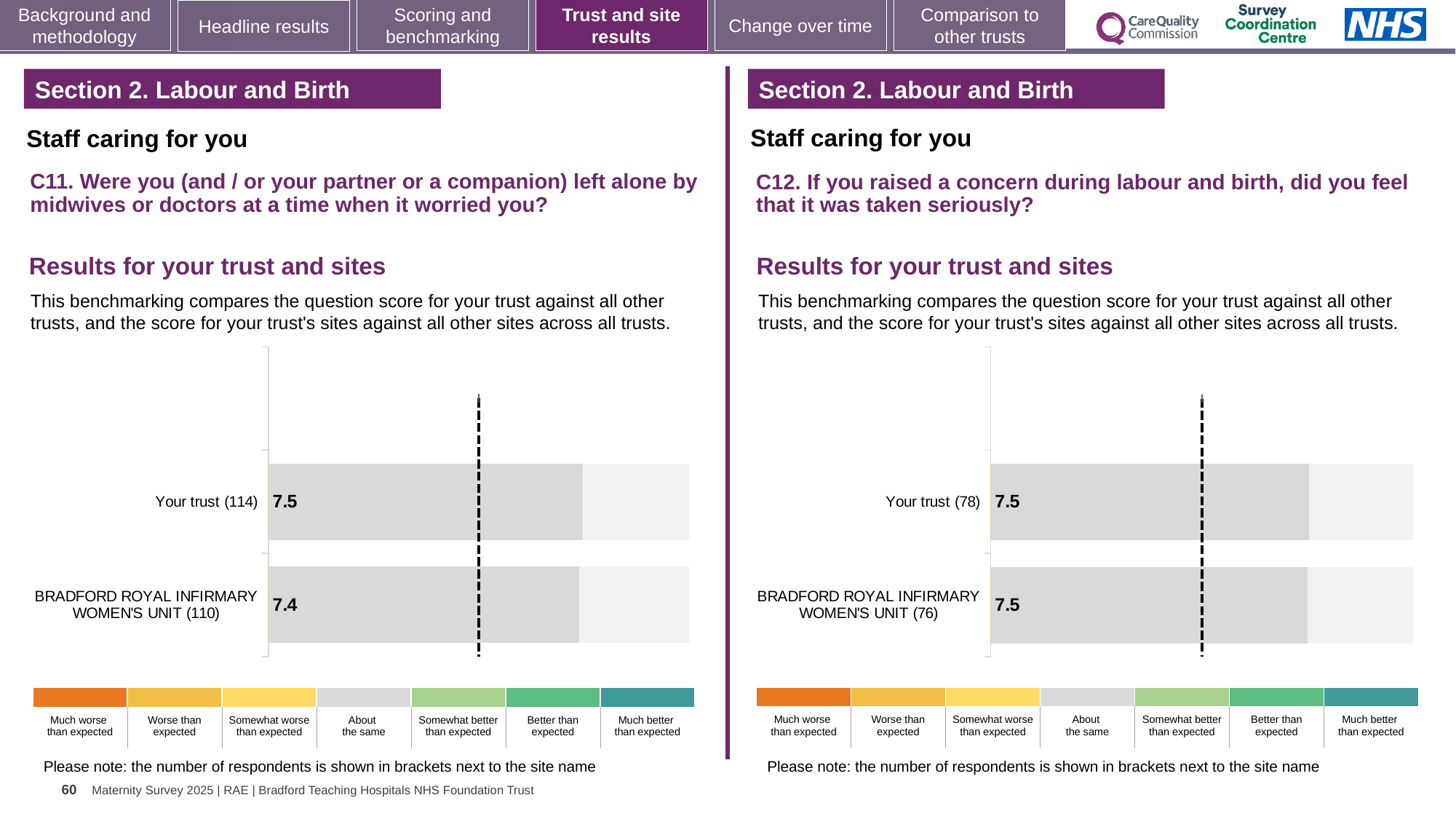
In the C11 chart on the left, which category has the lowest score? Bradford Royal Infirmary Women's Unit In the C11 chart on the left, what is the difference between the score for Your trust and the score for Bradford Royal Infirmary Women's Unit? 0.1 What type of chart is used in the C11 chart on the left? Bar chart In the C11 chart on the left, what is the score for Your trust? 7.5 In the C12 chart on the right, how many respondents are shown in brackets for Bradford Royal Infirmary Women's Unit? 76 In the C12 chart on the right, what is the difference between the score for Your trust and the score for Bradford Royal Infirmary Women's Unit? 0 In the C11 chart on the left, how many respondents are shown in brackets for Your trust? 114 How many bars are plotted in the C12 chart on the right? 2 In the C12 chart on the right, what is the score for Bradford Royal Infirmary Women's Unit? 7.5 In the C11 chart on the left, which has the higher score, Your trust or Bradford Royal Infirmary Women's Unit? Your trust In the C12 chart on the right, what is the score for Your trust? 7.5 In the C11 chart on the left, what is the score for Bradford Royal Infirmary Women's Unit? 7.4